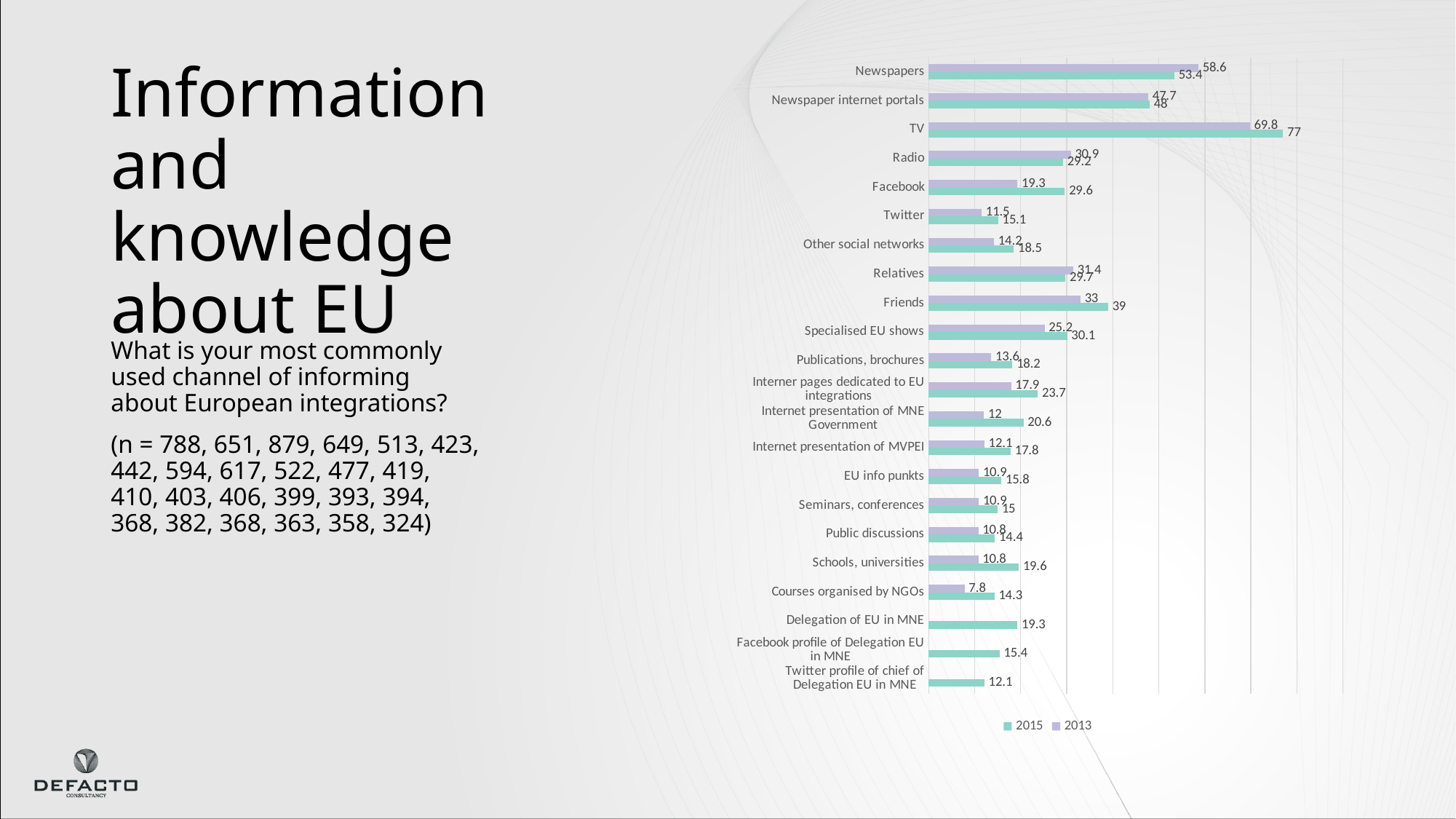
How many series does the legend list? 2 What is the difference between the 2015 and 2013 values for Facebook? 10.3 What is the 2015 value for TV? 77 What is the 2013 value for Newspapers? 58.6 What kind of chart is shown on the slide? Bar chart Which category has the lowest 2013 value? Courses organised by NGOs Which category has the highest 2015 value? TV Which is larger for Friends: the 2013 value or the 2015 value? 2015 What is the 2015 value for Delegation of EU in MNE? 19.3 What is the difference between the 2015 and 2013 values for TV? 7.2 How many categories are shown on the chart? 22 Which is larger for Radio: the 2013 value or the 2015 value? 2013